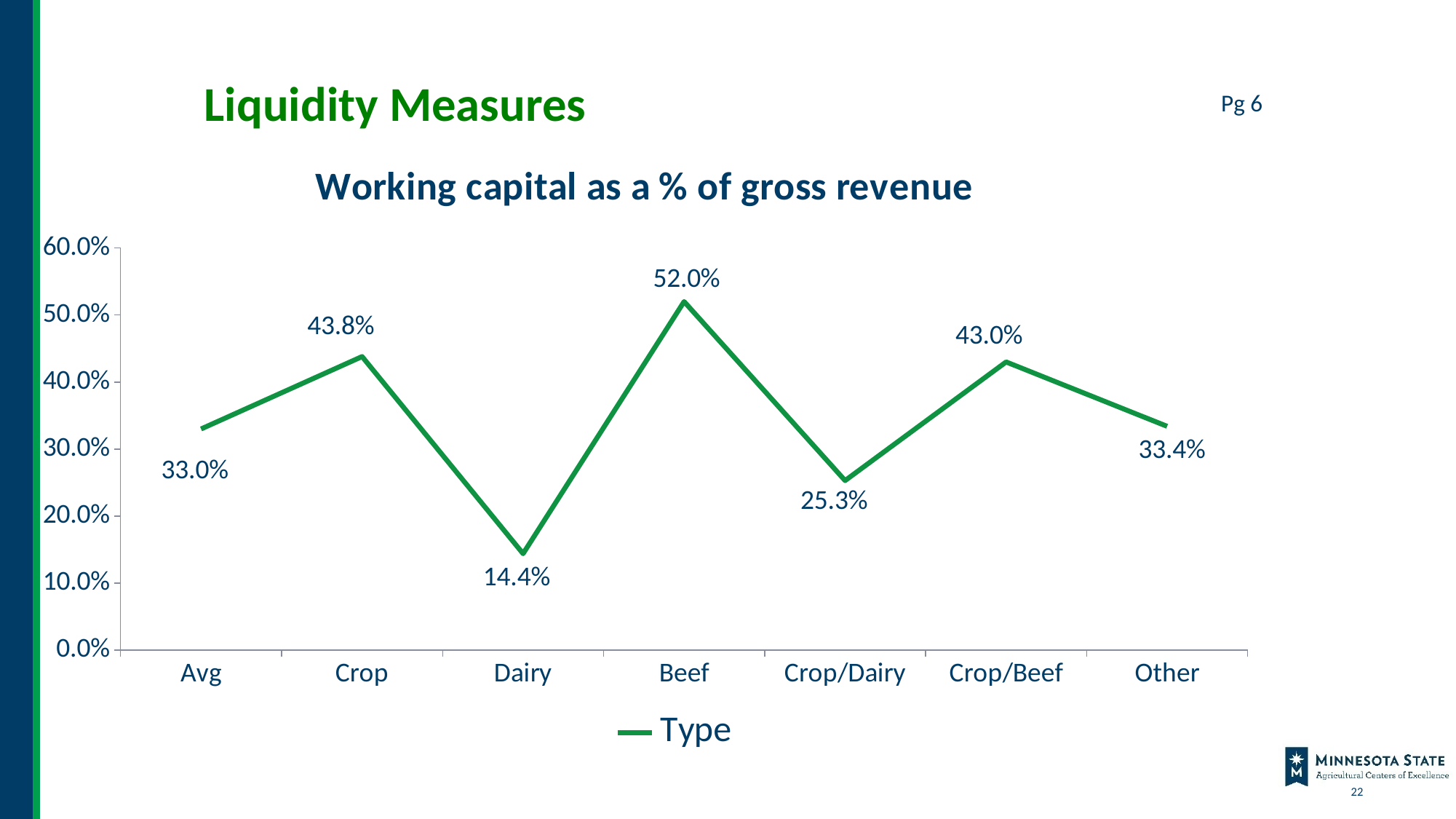
What is the working capital as a % of gross revenue for Beef? 52.0% Which category has the lowest working capital as a % of gross revenue? Dairy How many categories are shown on the x axis? 7 What is the value for Crop/Dairy? 25.3% What is the value for Dairy? 14.4% What is the difference between the values for Crop and Crop/Beef? 0.8% What is the title of the chart? Working capital as a % of gross revenue What is the difference between the values for Beef and Dairy? 37.6% Which is larger, the value for Crop/Dairy or the value for Other? Other What is the value for Other? 33.4% Which category has the highest working capital as a % of gross revenue? Beef What kind of chart is shown on the slide? Line chart